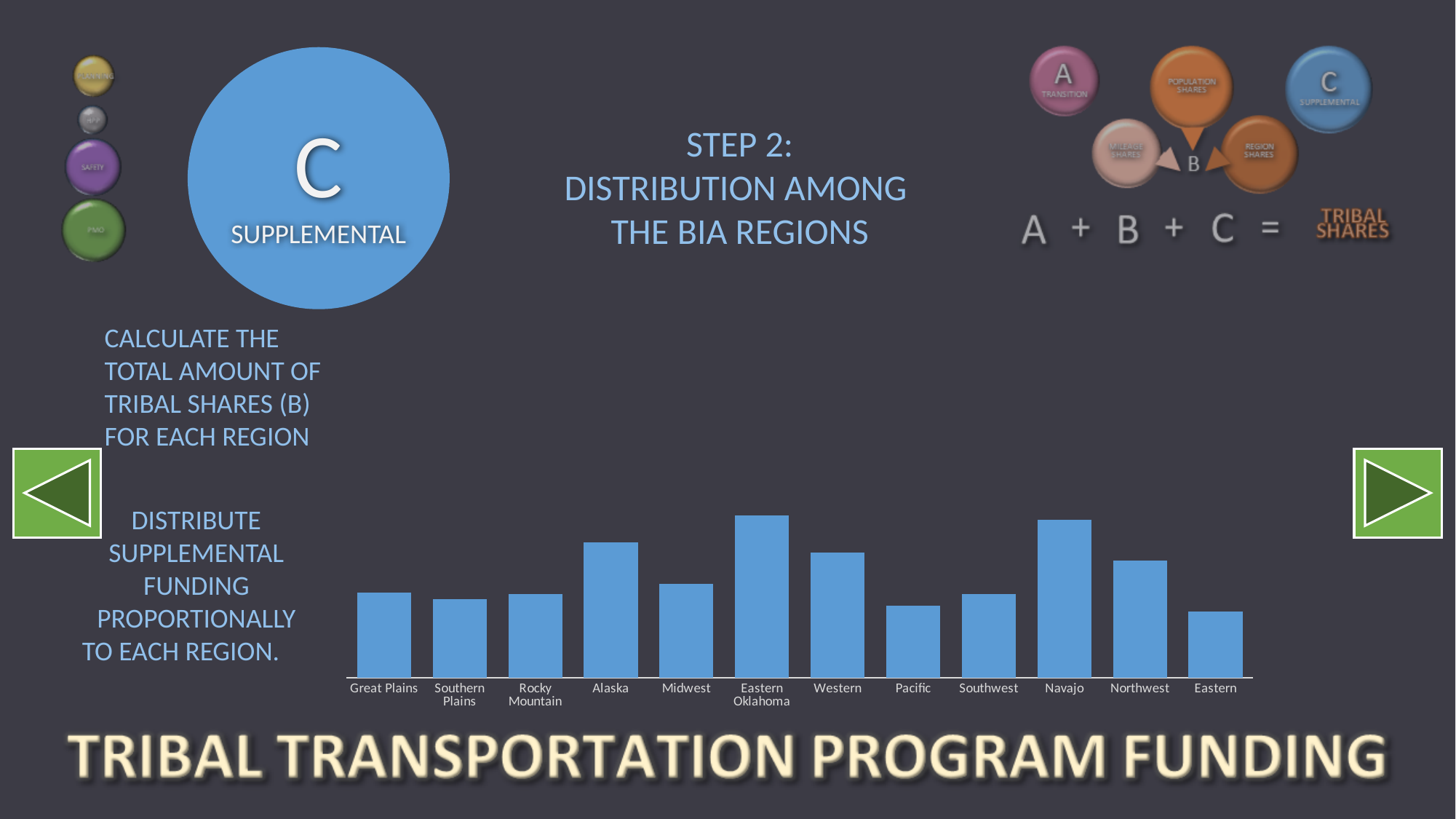
Which has the taller bar, Northwest or Eastern? Northwest Which has the taller bar, Eastern Oklahoma or Western? Eastern Oklahoma Which has the taller bar, Midwest or Pacific? Midwest What colour are the bars in the chart? blue How many BIA regions are shown as categories on the bar chart? 12 What kind of chart is shown on the slide? bar chart What is the first category on the left of the bar chart's x axis? Great Plains